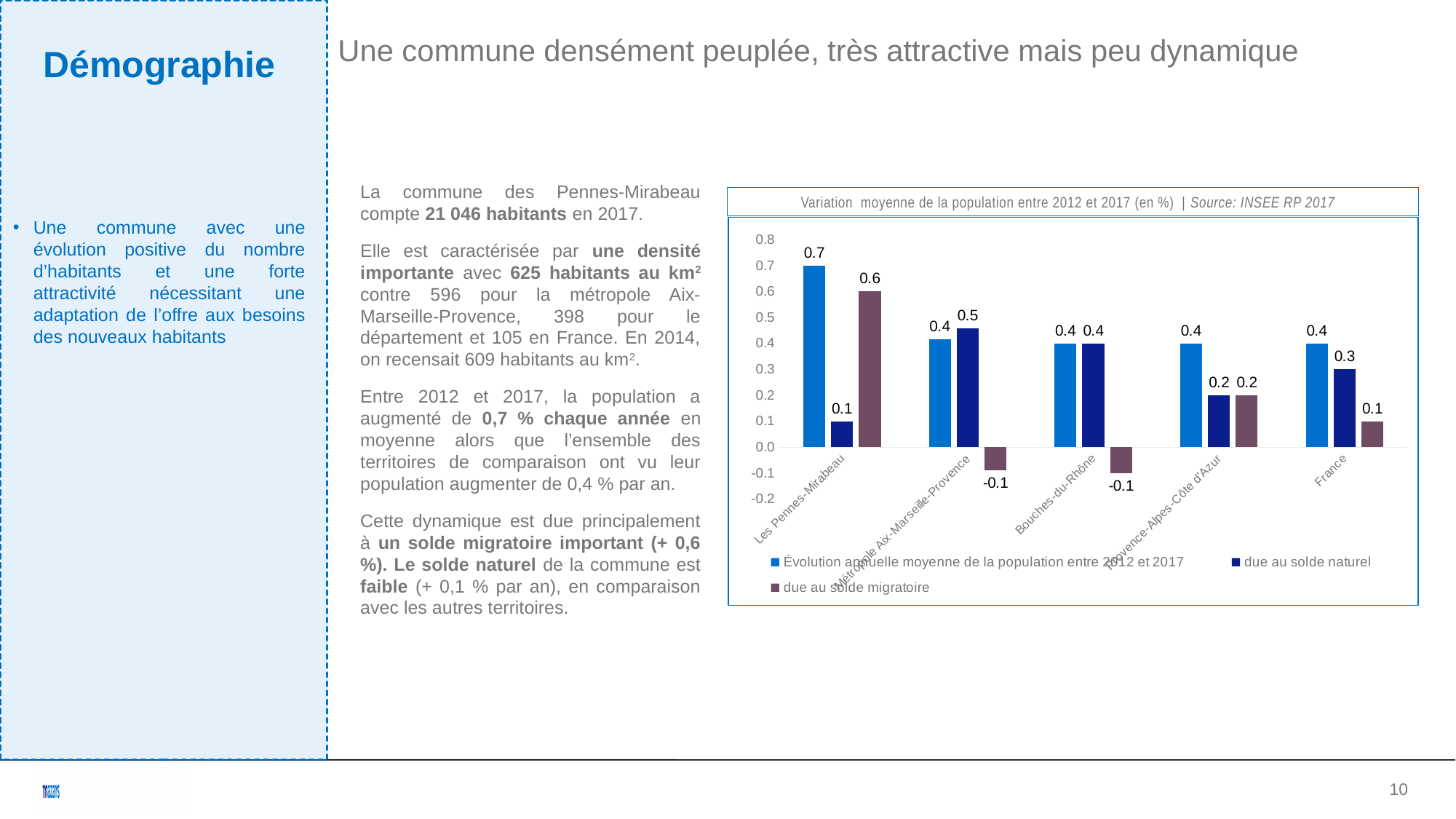
What kind of chart is shown on the slide? Bar chart What is the value 'due au solde naturel' for France? 0.3 How many categories are shown on the x axis of the chart? 5 What source is cited in the chart title? INSEE RP 2017 What is the difference between the 'due au solde migratoire' value for Les Pennes-Mirabeau and for France? 0.5 What is the value 'due au solde migratoire' for Les Pennes-Mirabeau? 0.6 Which is larger for Métropole Aix-Marseille-Provence: the value 'due au solde naturel' or the value 'due au solde migratoire'? due au solde naturel Which category has the highest value for 'Évolution annuelle moyenne de la population entre 2012 et 2017'? Les Pennes-Mirabeau How many series does the chart legend list? 3 What is the value of 'Évolution annuelle moyenne de la population entre 2012 et 2017' for Les Pennes-Mirabeau? 0.7 What is the value 'due au solde migratoire' for Bouches-du-Rhône? -0.1 Which category has the lowest value 'due au solde naturel'? Les Pennes-Mirabeau